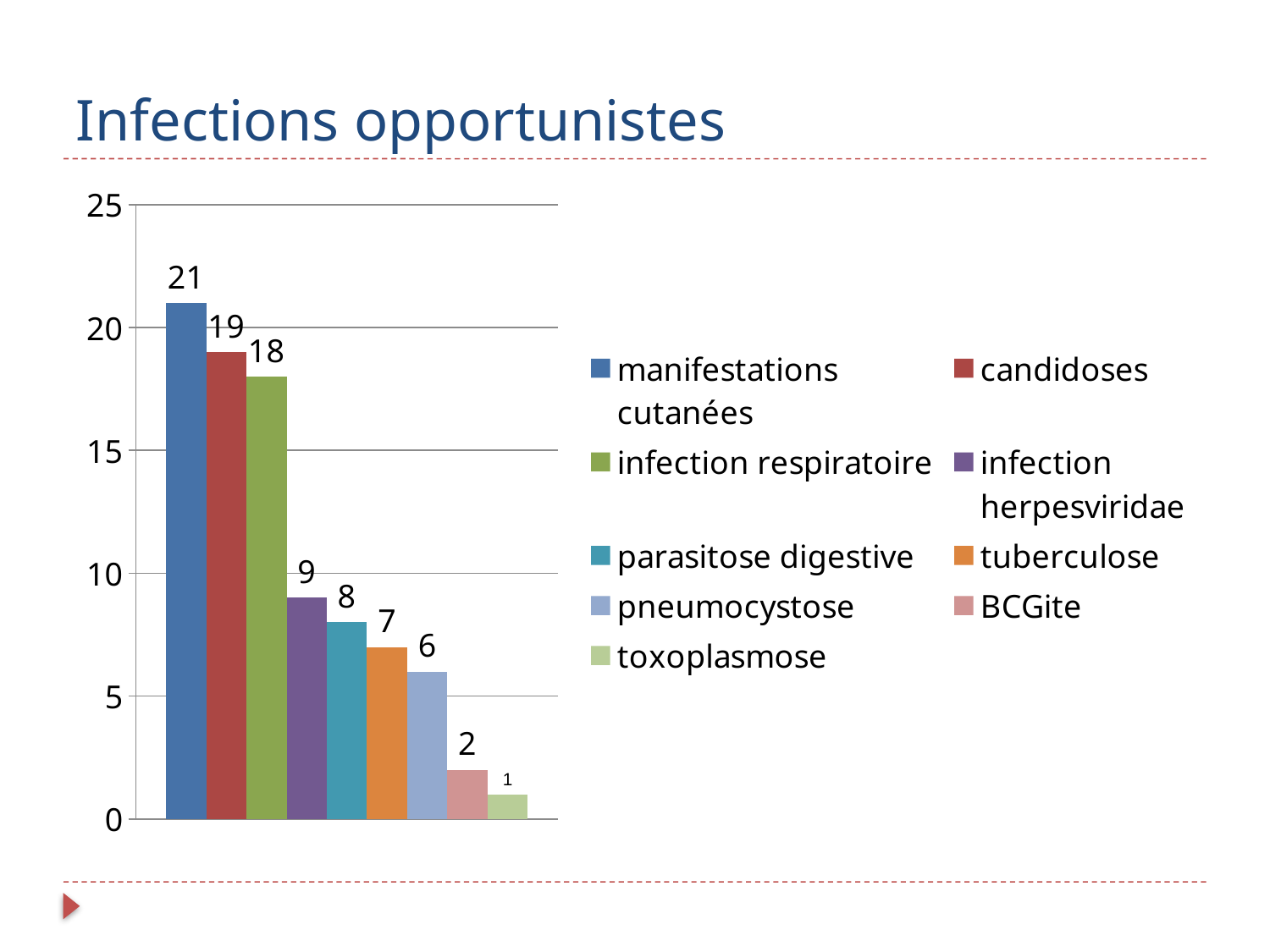
What is the title of the slide containing the chart? Infections opportunistes What kind of chart is shown on the slide? bar chart Is the value for candidoses greater or less than 15? greater Which category has the highest value? manifestations cutanées What is the value for manifestations cutanées? 21 Which category has the lowest value? toxoplasmose Which is larger, the value for parasitose digestive or the value for pneumocystose? parasitose digestive What is the value for toxoplasmose? 1 What is the difference between the values for infection respiratoire and infection herpesviridae? 9 How many series does the legend list? 9 What is the value for tuberculose? 7 What is the value for candidoses? 19